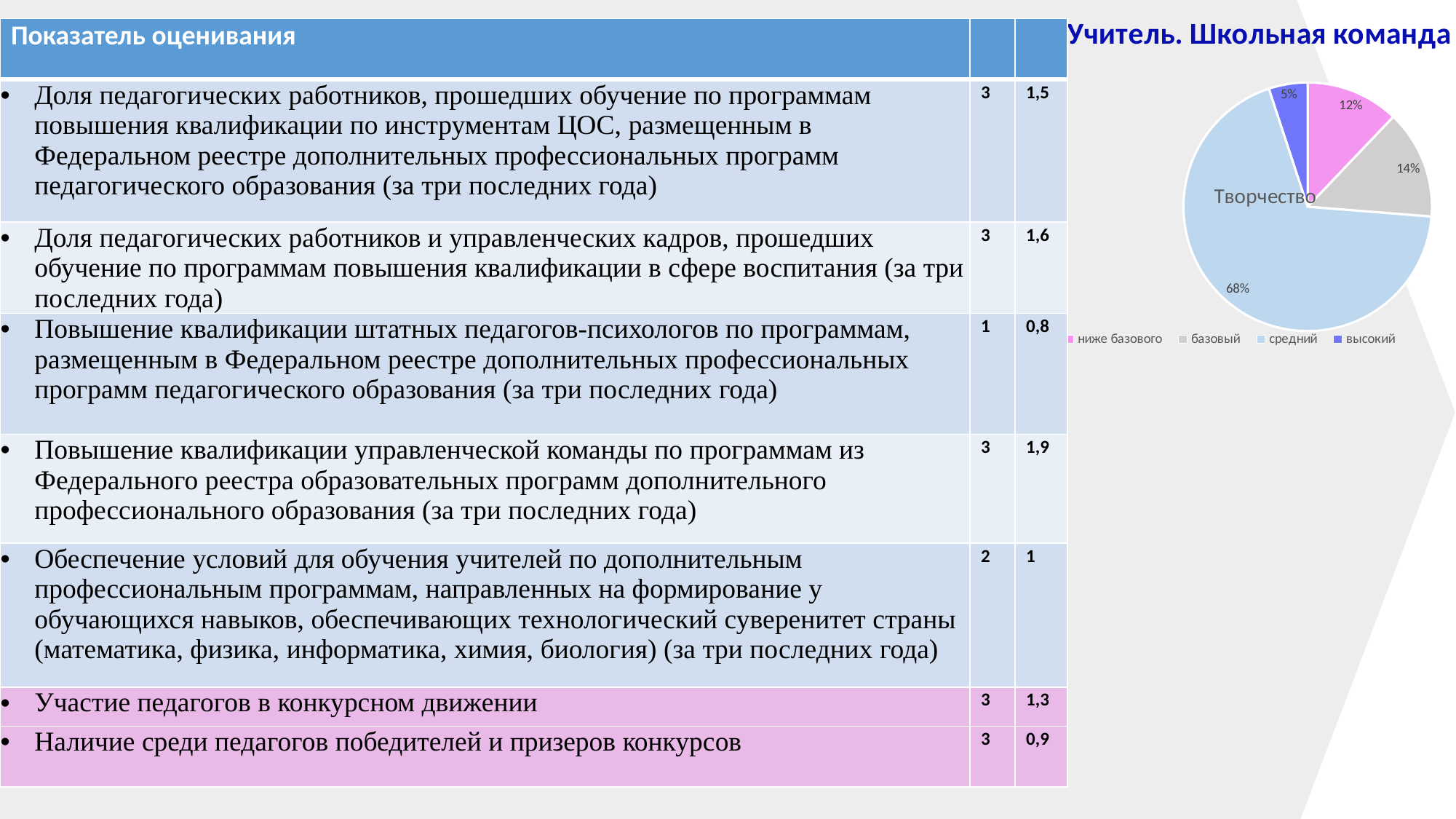
Which category has the smallest slice in the pie chart? высокий Which category has the largest slice in the pie chart? средний How many slices does the pie chart have? 4 How many entries does the pie chart legend list? 4 What percentage does the "базовый" slice of the pie chart show? 14% What percentage does the "средний" slice of the pie chart show? 68% What percentage does the "ниже базового" slice of the pie chart show? 12% Which slice is larger in the pie chart, "ниже базового" or "базовый"? базовый What kind of chart is shown on the slide? pie chart By how many percentage points is the "средний" slice larger than the "базовый" slice? 54 What percentage does the "высокий" slice of the pie chart show? 5% What word is written inside the pie chart? Творчество